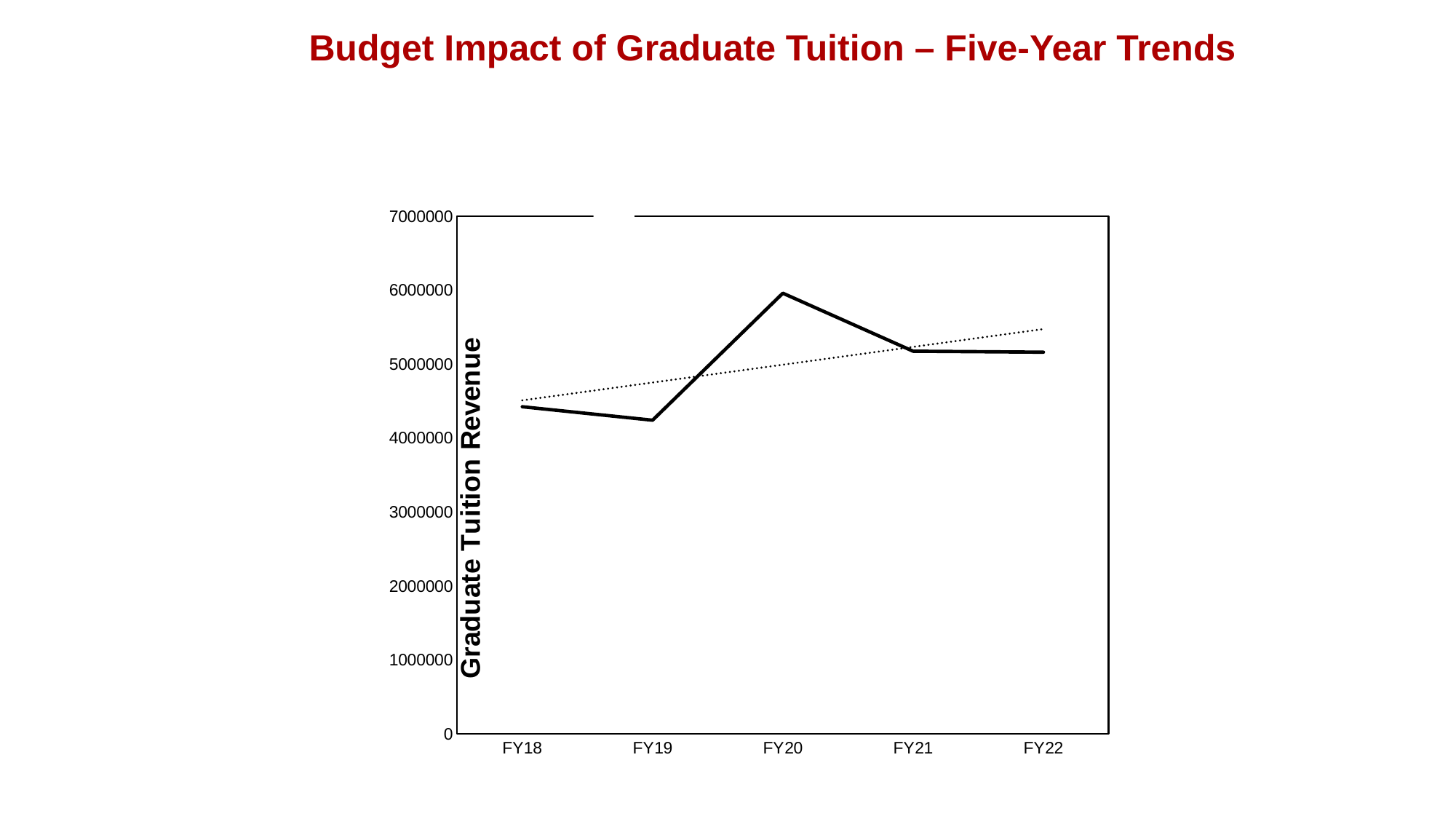
Is the graduate tuition revenue for FY18 greater or less than 4000000? greater Which has the higher graduate tuition revenue, FY20 or FY21? FY20 How many fiscal years are plotted on the x axis? 5 What is the label on the y axis of the chart? Graduate Tuition Revenue Which fiscal year has the highest graduate tuition revenue? FY20 Which fiscal year has the lowest graduate tuition revenue? FY19 Is the graduate tuition revenue for FY19 greater or less than 5000000? less Does graduate tuition revenue rise or fall from FY19 to FY20? rise What kind of chart is shown on the slide? line chart Is the graduate tuition revenue for FY20 greater or less than 5000000? greater What is the title of the slide? Budget Impact of Graduate Tuition – Five-Year Trends